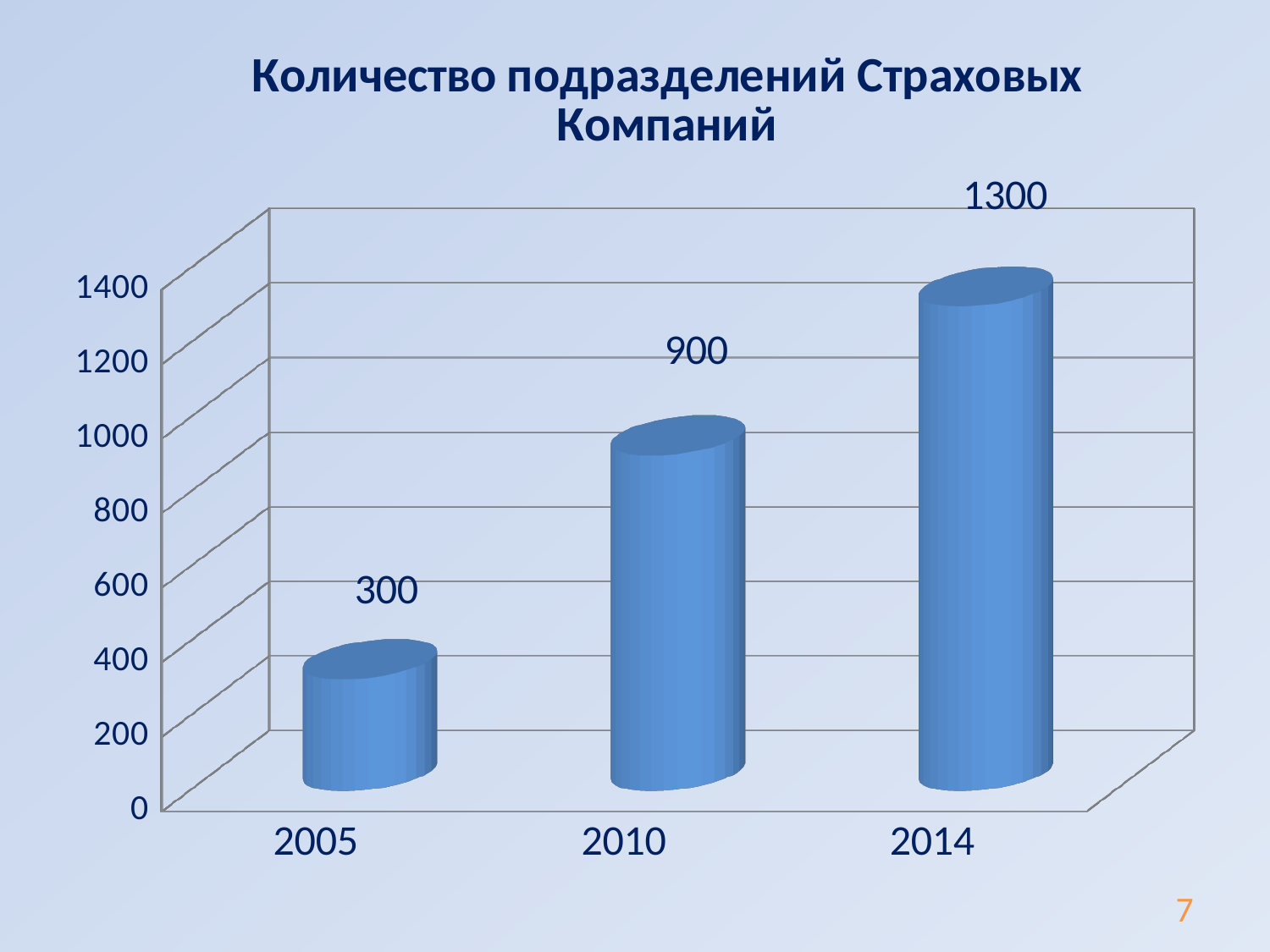
What is the difference between the values for 2014 and 2010? 400 How many years are shown on the x axis? 3 Which year has the lowest value? 2005 What is the value for 2005? 300 Which year has the highest value? 2014 Do the values rise or fall from 2005 to 2014? rise Is the value for 2014 greater or less than 1200? greater What is the value for 2010? 900 What is the value for 2014? 1300 What kind of chart is shown on the slide? bar chart What is the difference between the values for 2010 and 2005? 600 Which is larger, the value for 2010 or the value for 2005? 2010